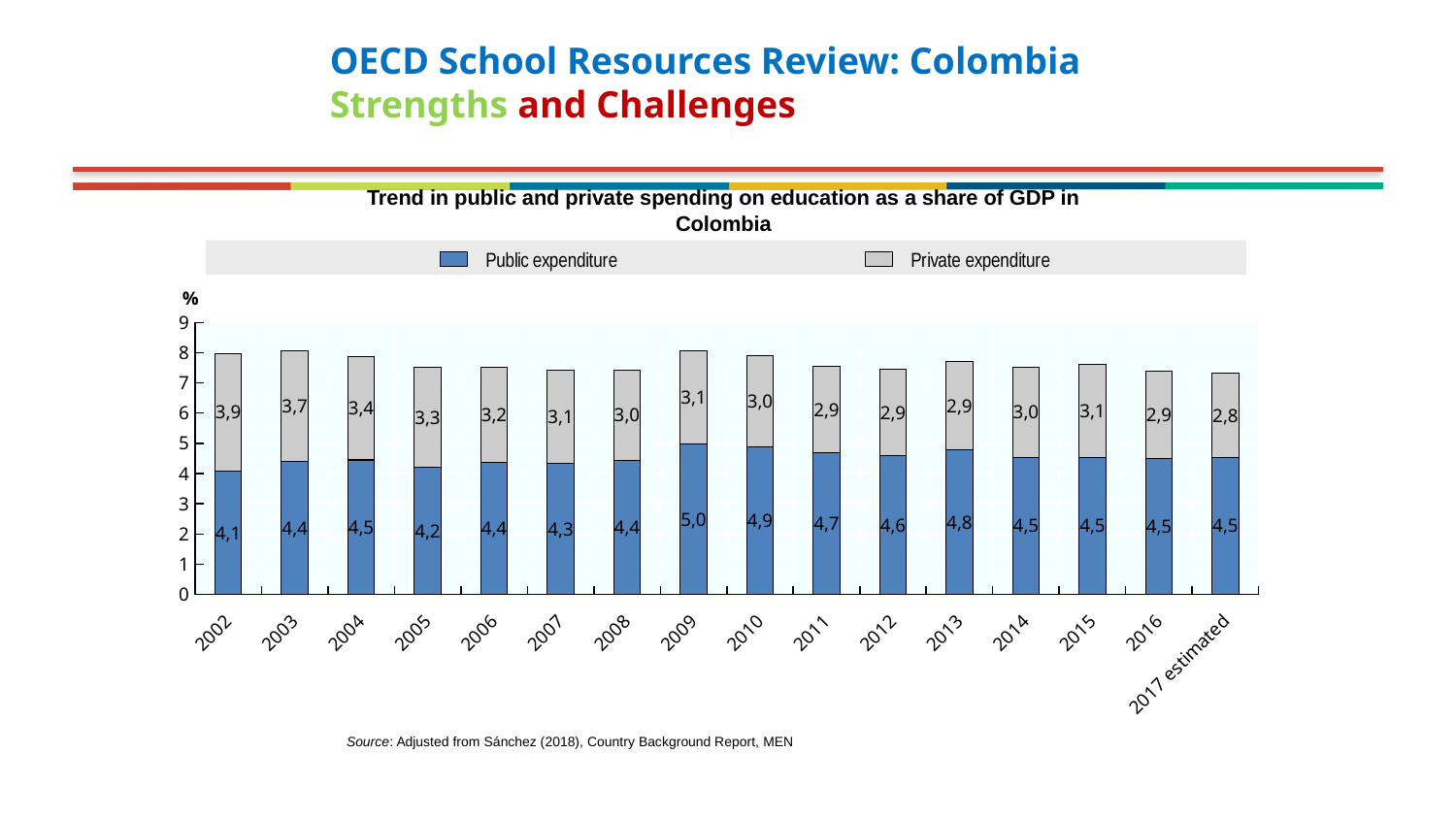
How many series does the legend list? 2 Which year has the lowest public expenditure? 2002 What is the total of public and private expenditure in 2003? 8,1 What is the private expenditure value for 2017 estimated? 2,8 What is the difference between public expenditure in 2009 and in 2002? 0,9 Which year has the highest public expenditure? 2009 What is the private expenditure value for 2002? 3,9 Is public expenditure larger in 2010 or in 2012? 2010 Which year has the highest private expenditure? 2002 How many years are shown on the x axis? 16 What kind of chart is shown? Stacked bar chart What is the public expenditure value for 2009? 5,0